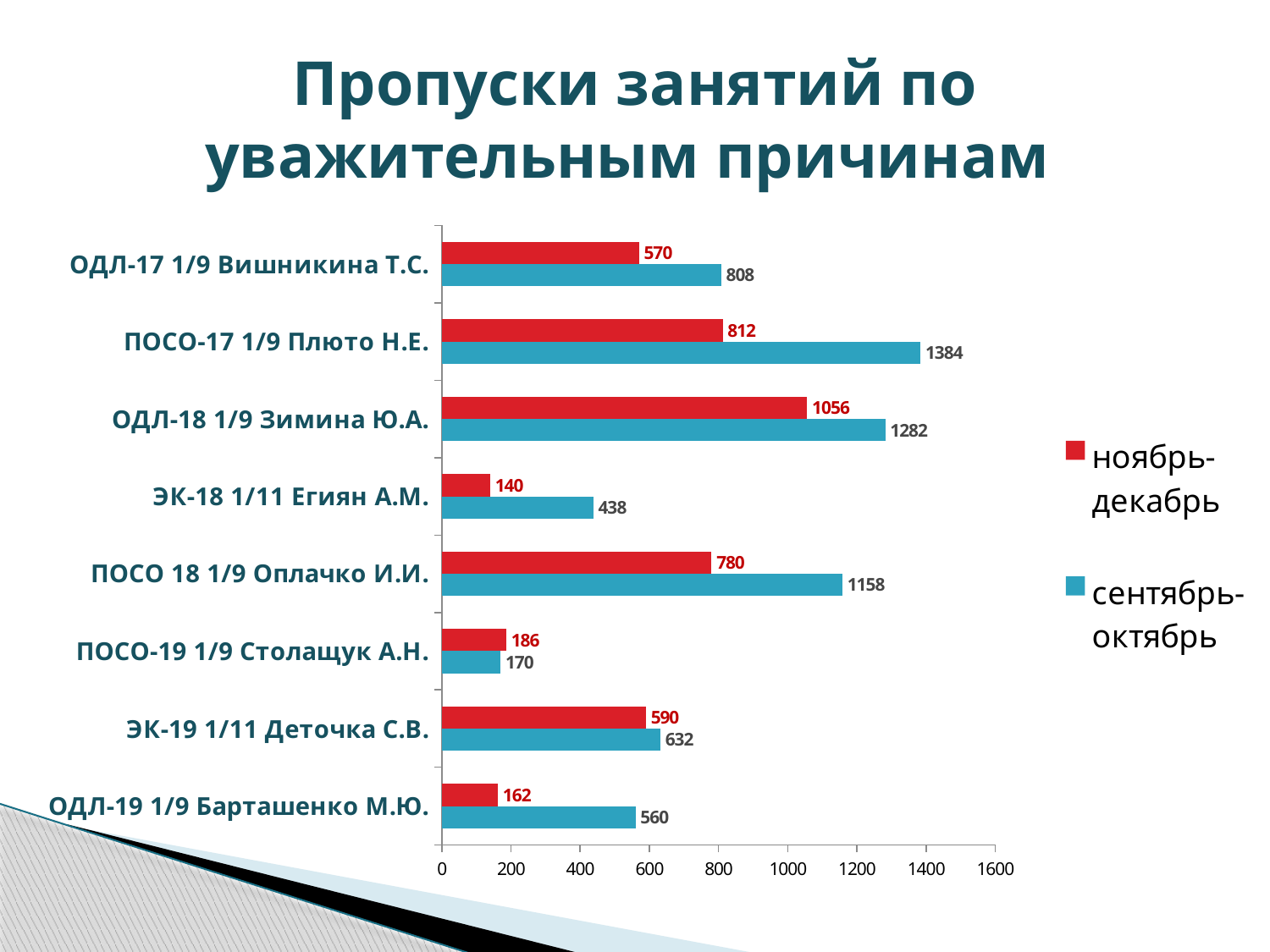
What is the difference between the сентябрь-октябрь and ноябрь-декабрь values for ПОСО 18 1/9 Оплачко И.И.? 378 How many categories are shown on the chart? 8 Which is larger for ПОСО-19 1/9 Столащук А.Н.: the ноябрь-декабрь value or the сентябрь-октябрь value? ноябрь-декабрь Is the сентябрь-октябрь value for ОДЛ-18 1/9 Зимина Ю.А. greater or less than 1200? greater What is the value for ЭК-18 1/11 Егиян А.М. in the ноябрь-декабрь series? 140 What is the title of the slide? Пропуски занятий по уважительным причинам What is the value for ПОСО-17 1/9 Плюто Н.Е. in the сентябрь-октябрь series? 1384 Which category has the highest value in the ноябрь-декабрь series? ОДЛ-18 1/9 Зимина Ю.А. How many series does the legend list? 2 Which category has the lowest value in the сентябрь-октябрь series? ПОСО-19 1/9 Столащук А.Н. What kind of chart is shown on the slide? bar chart Which colour represents the сентябрь-октябрь series? blue